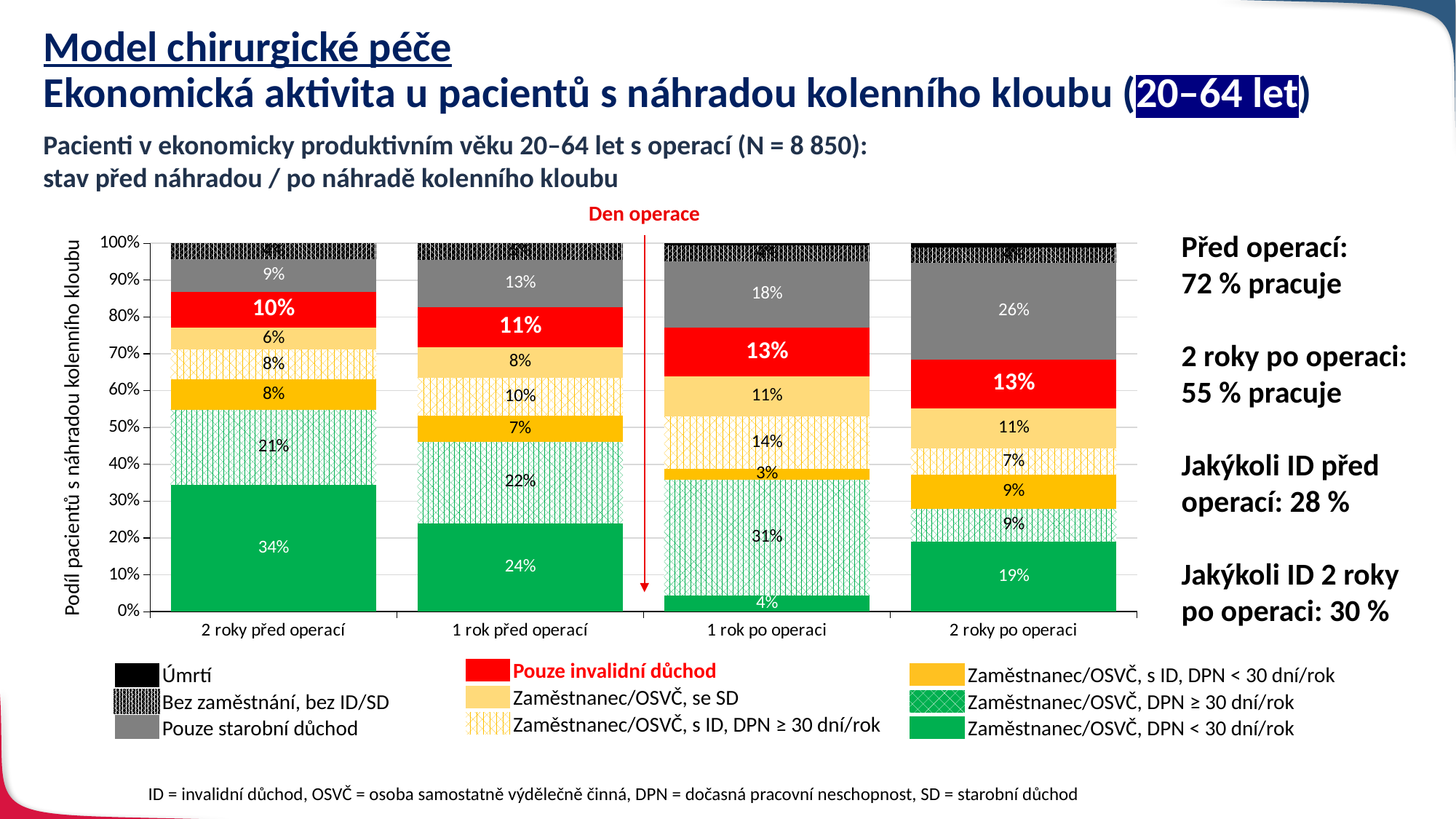
In which category is the 'Pouze starobní důchod' segment the largest? 2 roky po operaci What kind of chart is shown on the slide? Stacked bar chart What is the value for 'Pouze invalidní důchod' in the '2 roky před operací' bar? 10% What is the difference in 'Pouze starobní důchod' between '2 roky po operaci' and '2 roky před operací'? 17 percentage points In which category is the 'Zaměstnanec/OSVČ, DPN < 30 dní/rok' segment the smallest? 1 rok po operaci What is the value for 'Pouze starobní důchod' in the '2 roky po operaci' bar? 26% How many categories (time points) are shown on the x axis of the chart? 4 How many series does the chart's legend list? 9 Which is larger: 'Zaměstnanec/OSVČ, DPN ≥ 30 dní/rok' at '1 rok po operaci' or at '2 roky před operací'? 1 rok po operaci What does the red label above the arrow between the bars say? Den operace What is the value for 'Zaměstnanec/OSVČ, DPN < 30 dní/rok' in the '1 rok po operaci' bar? 4% Does the 'Pouze starobní důchod' share rise or fall from '2 roky před operací' to '2 roky po operaci'? Rises